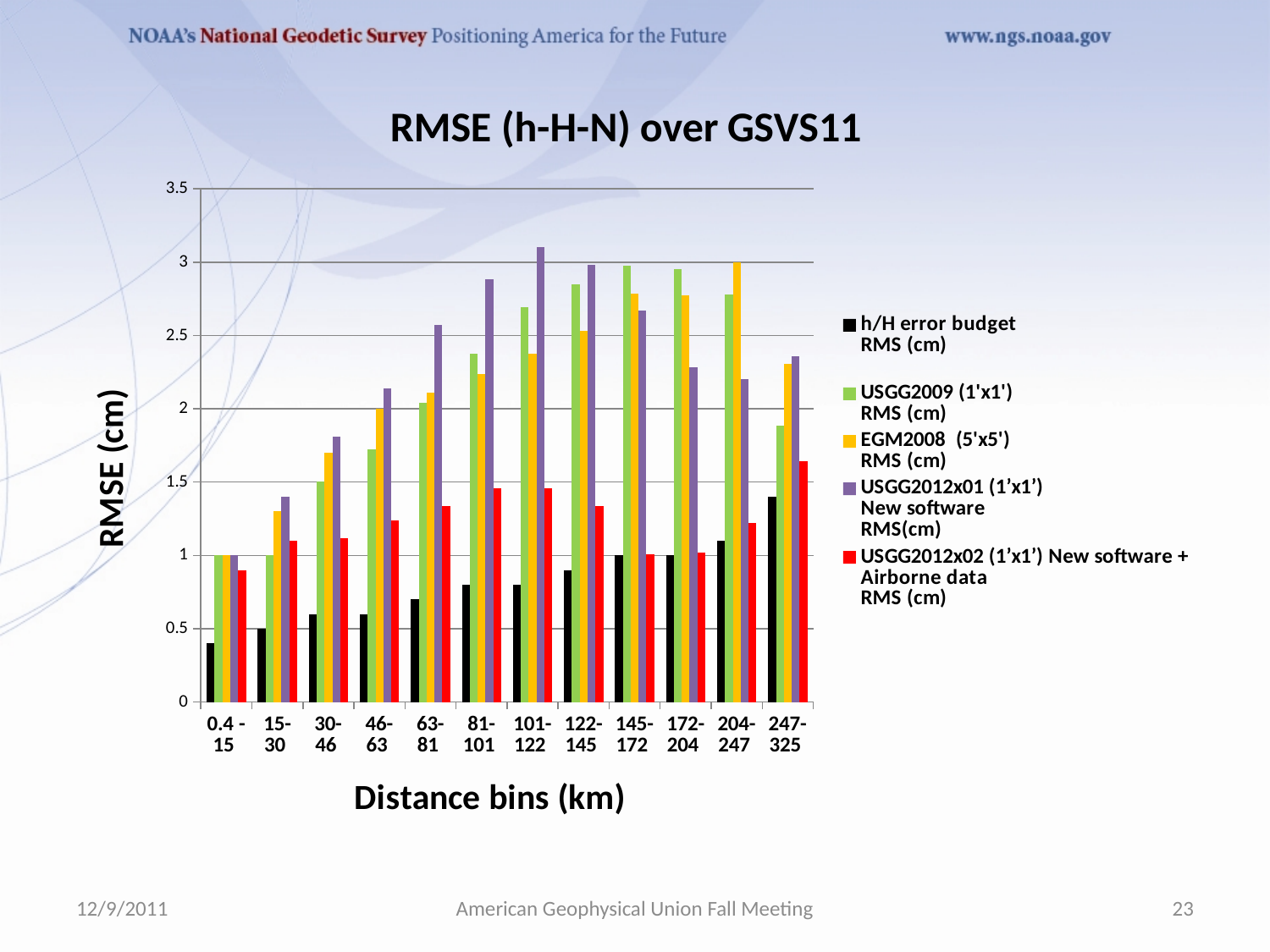
For which distance bin is the h/H error budget RMS value lowest? 0.4 - 15 What is the title of the chart? RMSE (h-H-N) over GSVS11 Does the h/H error budget RMS value generally rise or fall as the distance bins increase along the x axis? rise In the 247-325 bin, which is larger: the h/H error budget RMS or the USGG2012x02 (1'x1') New software + Airborne data RMS? USGG2012x02 (1'x1') New software + Airborne data RMS For which distance bin is the USGG2012x02 (1'x1') New software + Airborne data RMS value highest? 247-325 What kind of chart is shown on the slide? bar chart For which distance bin is the USGG2012x01 (1'x1') New software RMS value highest? 101-122 What is the label of the y axis? RMSE (cm) How many distance bins are shown on the x axis? 12 Is the USGG2009 (1'x1') RMS value for the 247-325 bin greater or less than 2? less How many series does the legend list? 5 Is the USGG2012x01 (1'x1') New software RMS value for the 101-122 bin greater or less than 3? greater